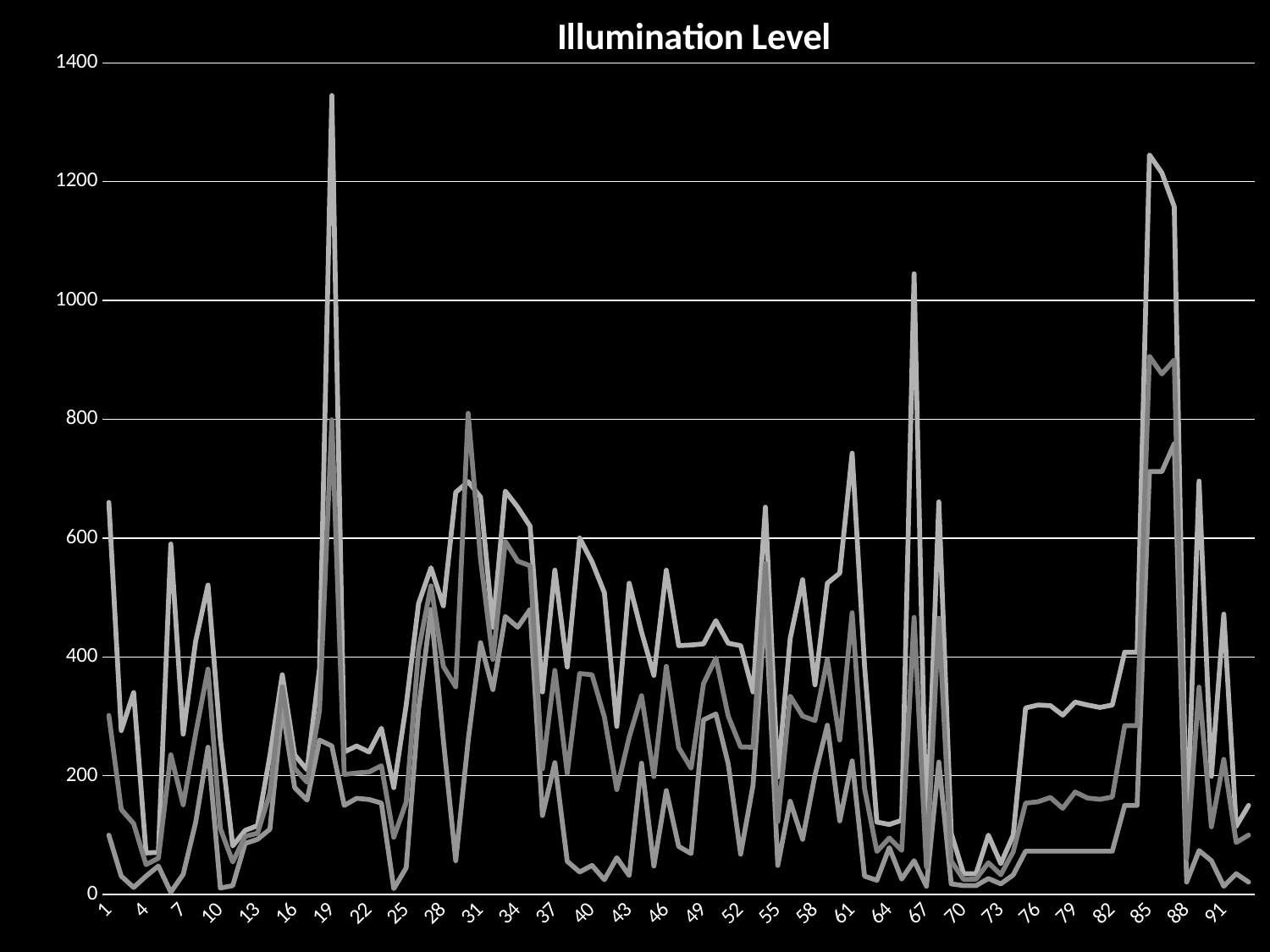
What is the title of the chart? Illumination Level What is the last label shown on the x axis? 91 What is the first label on the x axis? 1 Is the highest peak on the chart greater or less than 1400? less Is the highest peak on the chart greater or less than 1200? greater What kind of chart is shown on the slide? line chart